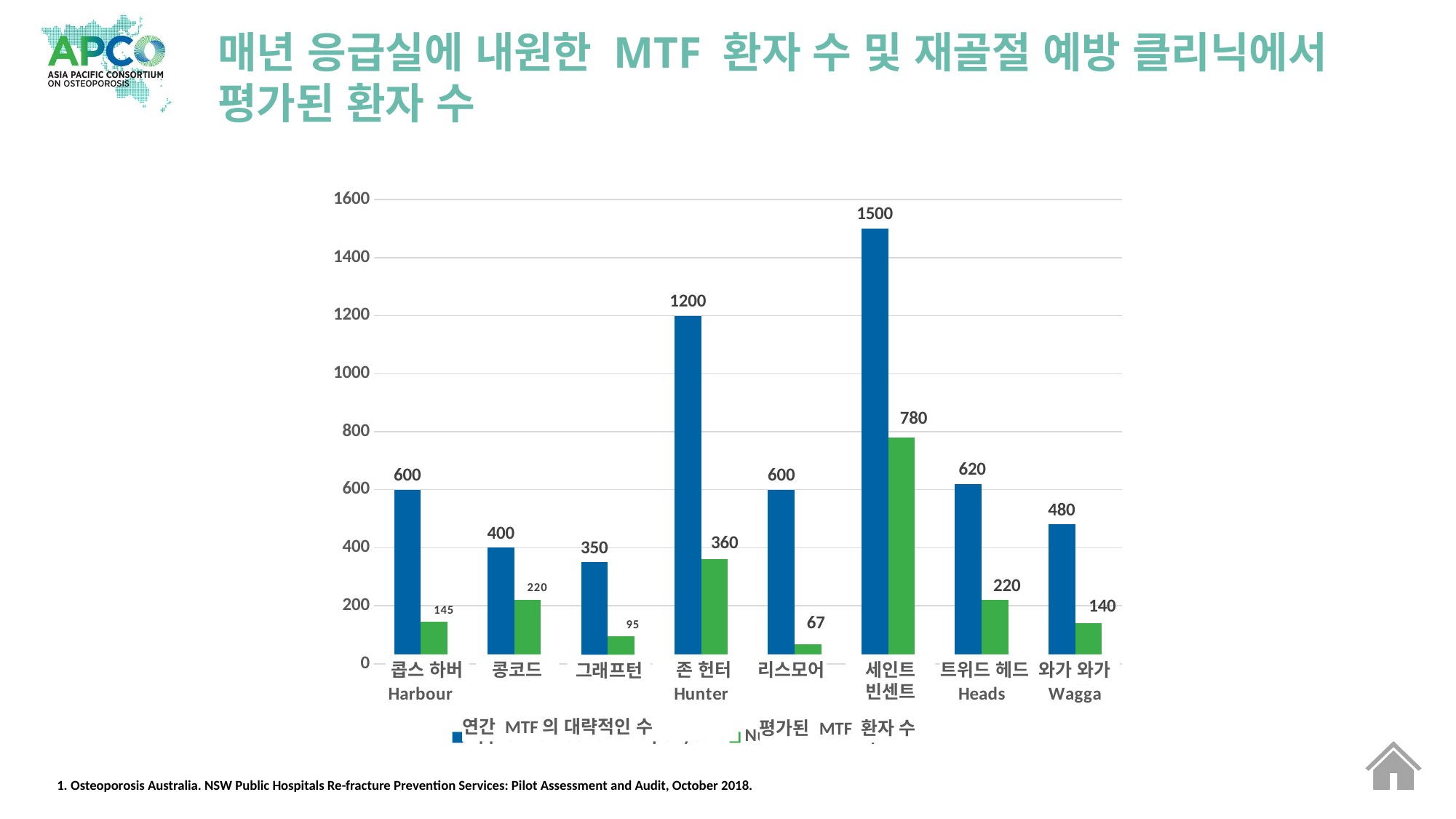
What is the value of the green bar (평가된 MTF 환자 수) for 리스모어? 67 How many series does the chart's legend list? 2 What type of chart is shown on the slide? bar chart How many hospital categories are shown on the x axis of the chart? 8 What is the difference between the blue bar values for 세인트 빈센트 and 존 헌터? 300 What colour are the bars for the 평가된 MTF 환자 수 series? green What is the difference between the blue bar and the green bar for 콥스 하버? 455 Which is larger: the blue bar for 트위드 헤드 or the blue bar for 와가 와가? 트위드 헤드 What is the value of the blue bar (연간 MTF의 대략적인 수) for 존 헌터? 1200 Which hospital has the highest value for the blue series (연간 MTF의 대략적인 수)? 세인트 빈센트 What is the value of the green bar (평가된 MTF 환자 수) for 세인트 빈센트? 780 Which hospital has the lowest value for the green series (평가된 MTF 환자 수)? 리스모어